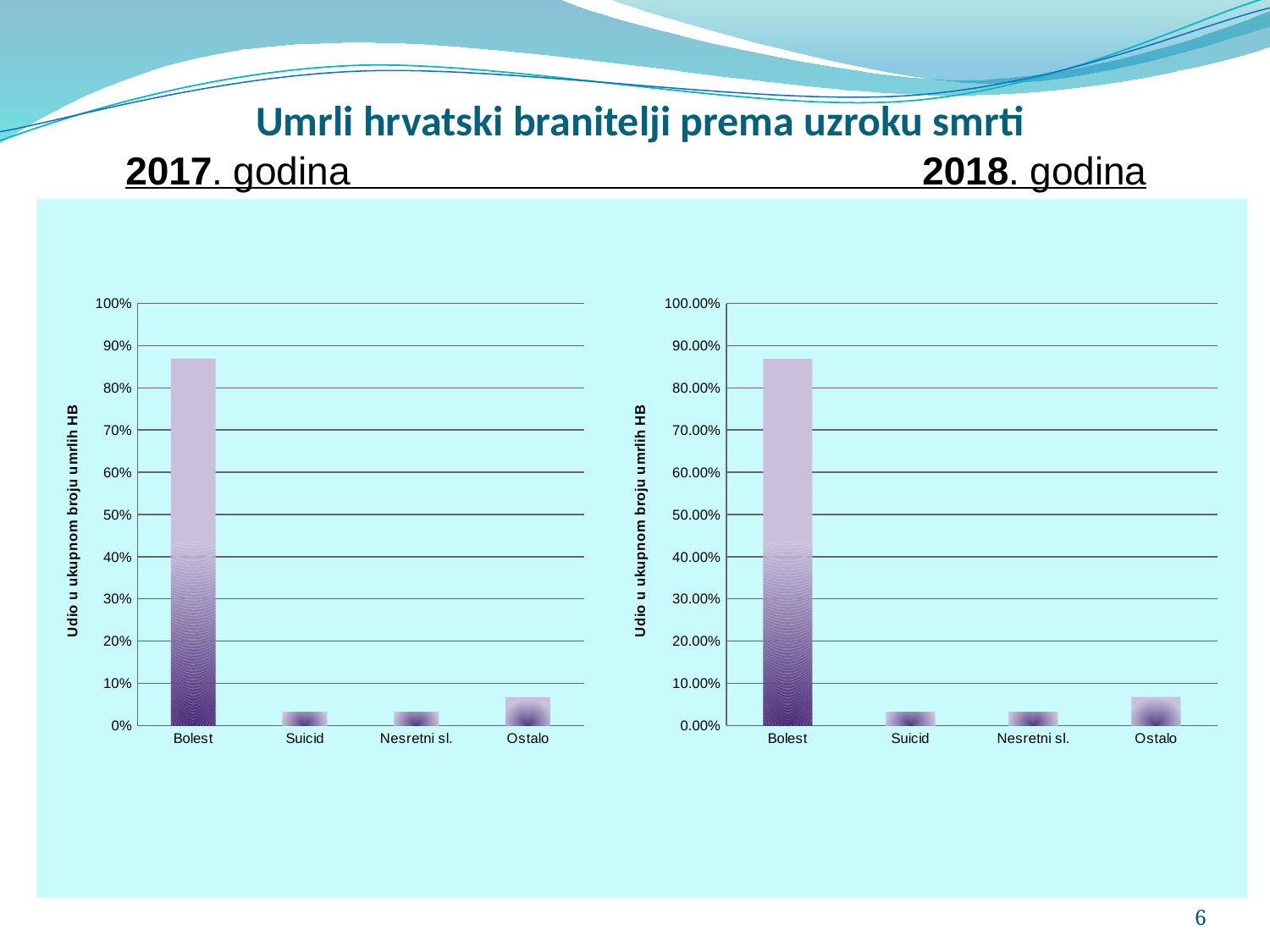
What is the y-axis title of the 2017. godina chart on the left? Udio u ukupnom broju umrlih HB What kind of chart is the 2017. godina chart on the left? bar chart How many categories are shown on the x axis of the 2018. godina chart on the right? 4 In the 2018. godina chart on the right, is the value for Suicid greater or less than 10.00%? less In the 2018. godina chart on the right, is the value for Bolest greater or less than 90.00%? less In the 2017. godina chart on the left, which category has the highest value? Bolest In the 2018. godina chart on the right, which category has the highest value? Bolest In the 2017. godina chart on the left, is the value for Bolest greater or less than 80%? greater In the 2017. godina chart on the left, which is larger, the value for Ostalo or the value for Suicid? Ostalo What is the title shown above the two charts on the slide? Umrli hrvatski branitelji prema uzroku smrti In the 2018. godina chart on the right, which is larger, the value for Bolest or the value for Ostalo? Bolest